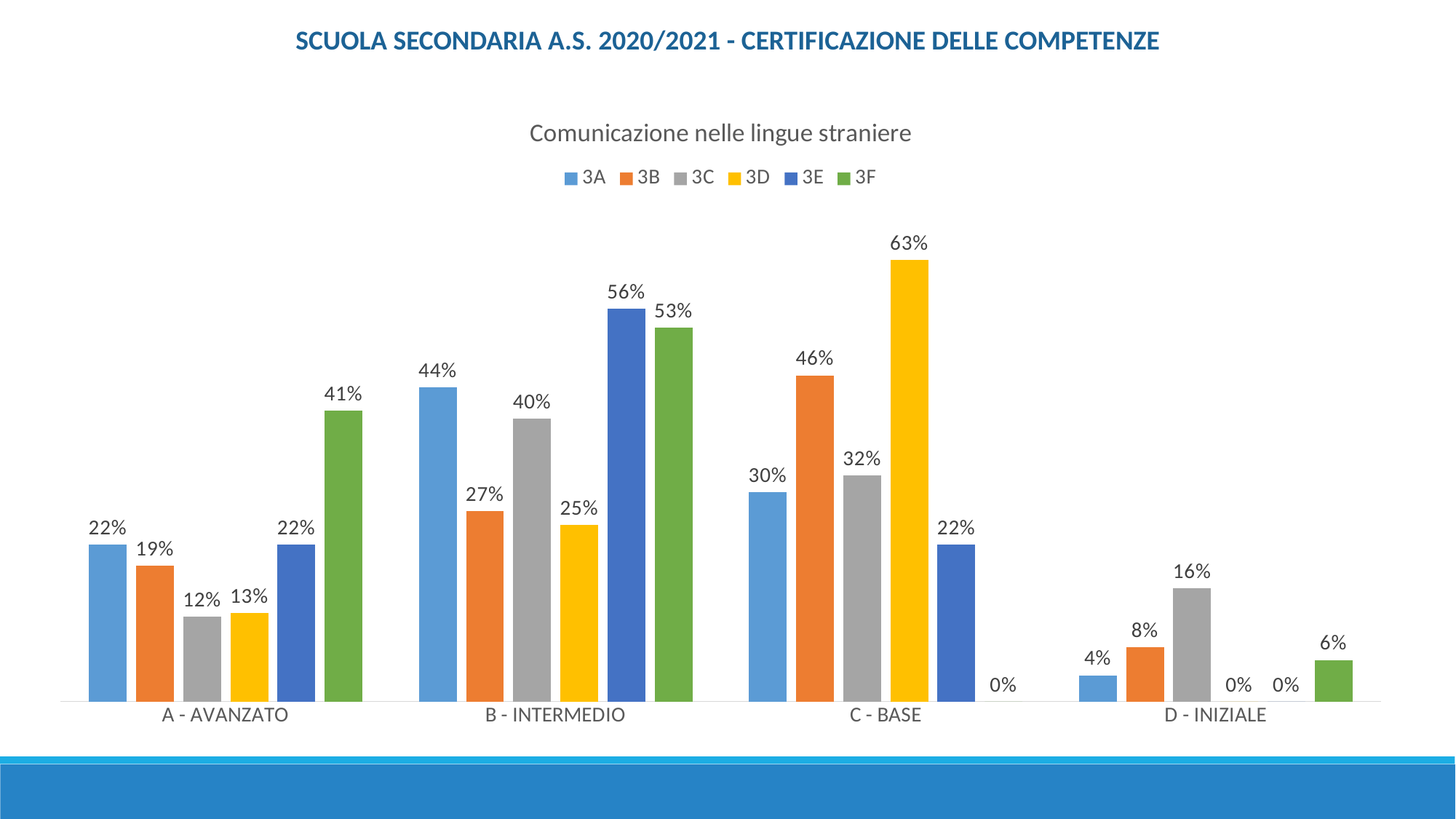
Which is larger in the B - INTERMEDIO category: the value for 3A or the value for 3C? 3A What is the value for 3F in the A - AVANZATO category? 41% What is the value for 3E in the B - INTERMEDIO category? 56% Which series has the highest value in the B - INTERMEDIO category? 3E How many series does the legend list? 6 Which series has the lowest value in the A - AVANZATO category? 3C What is the value for 3D in the C - BASE category? 63% What kind of chart is shown on the slide? Bar chart What is the value for 3C in the D - INIZIALE category? 16% What is the difference between the 3D and 3B values in the C - BASE category? 17% What is the title of the chart? Comunicazione nelle lingue straniere How many categories are shown on the x axis? 4